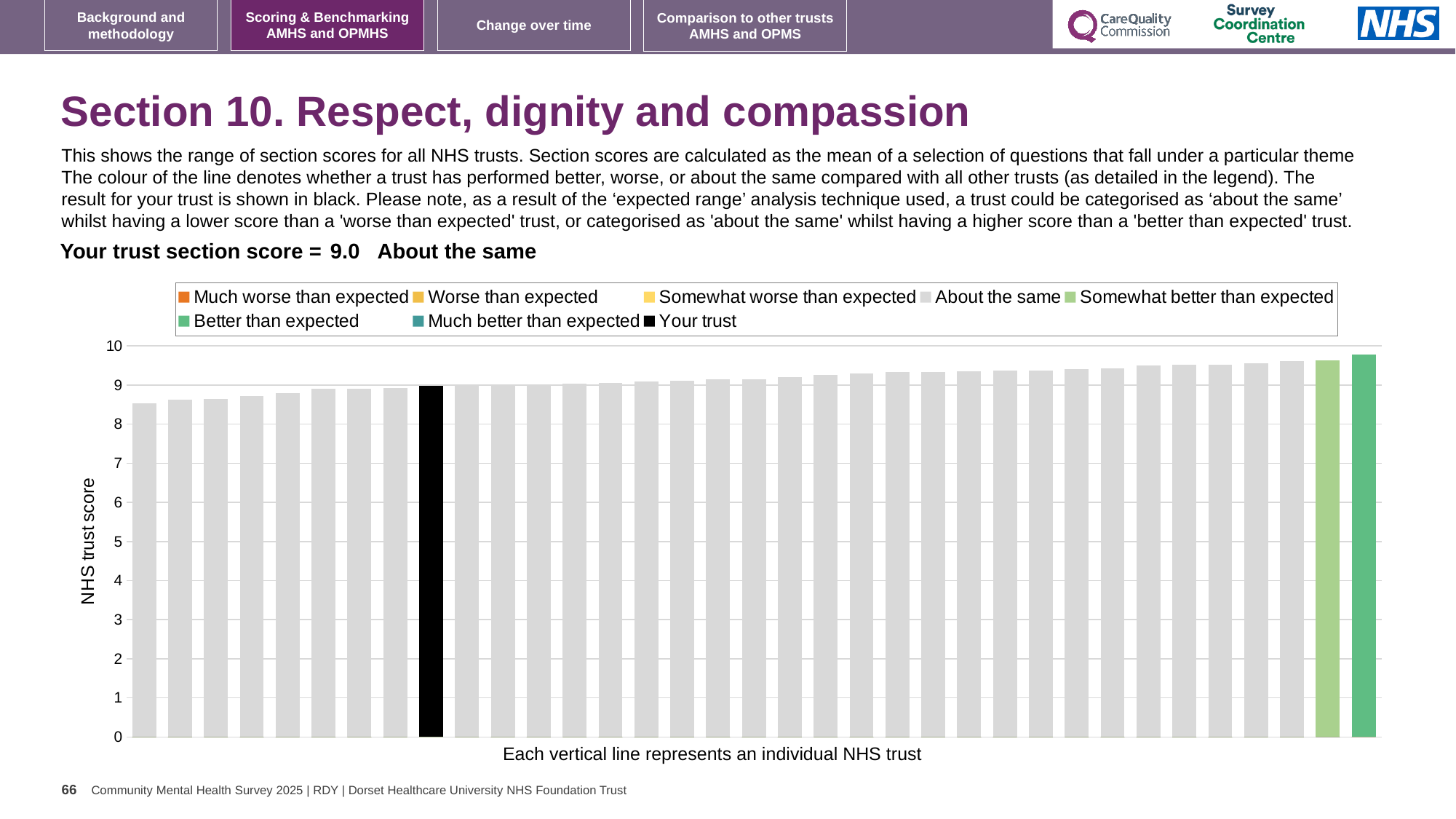
Which is taller: the black bar for your trust or the leftmost bar? The black bar for your trust What colour is the bar representing your trust? Black What type of chart is shown on the slide? Bar chart Is the value of the leftmost bar greater or less than 9? less Is the value of the rightmost bar greater or less than 9? greater What is the section score for your trust shown on the slide? 9.0 How many entries does the chart legend list? 8 Do the bar values rise or fall from left to right across the chart? Rise Is the value of the leftmost bar greater or less than 8? greater What is the label on the vertical axis of the chart? NHS trust score Which bar is the highest in the chart? The rightmost bar Which category is your trust placed in for this section? About the same